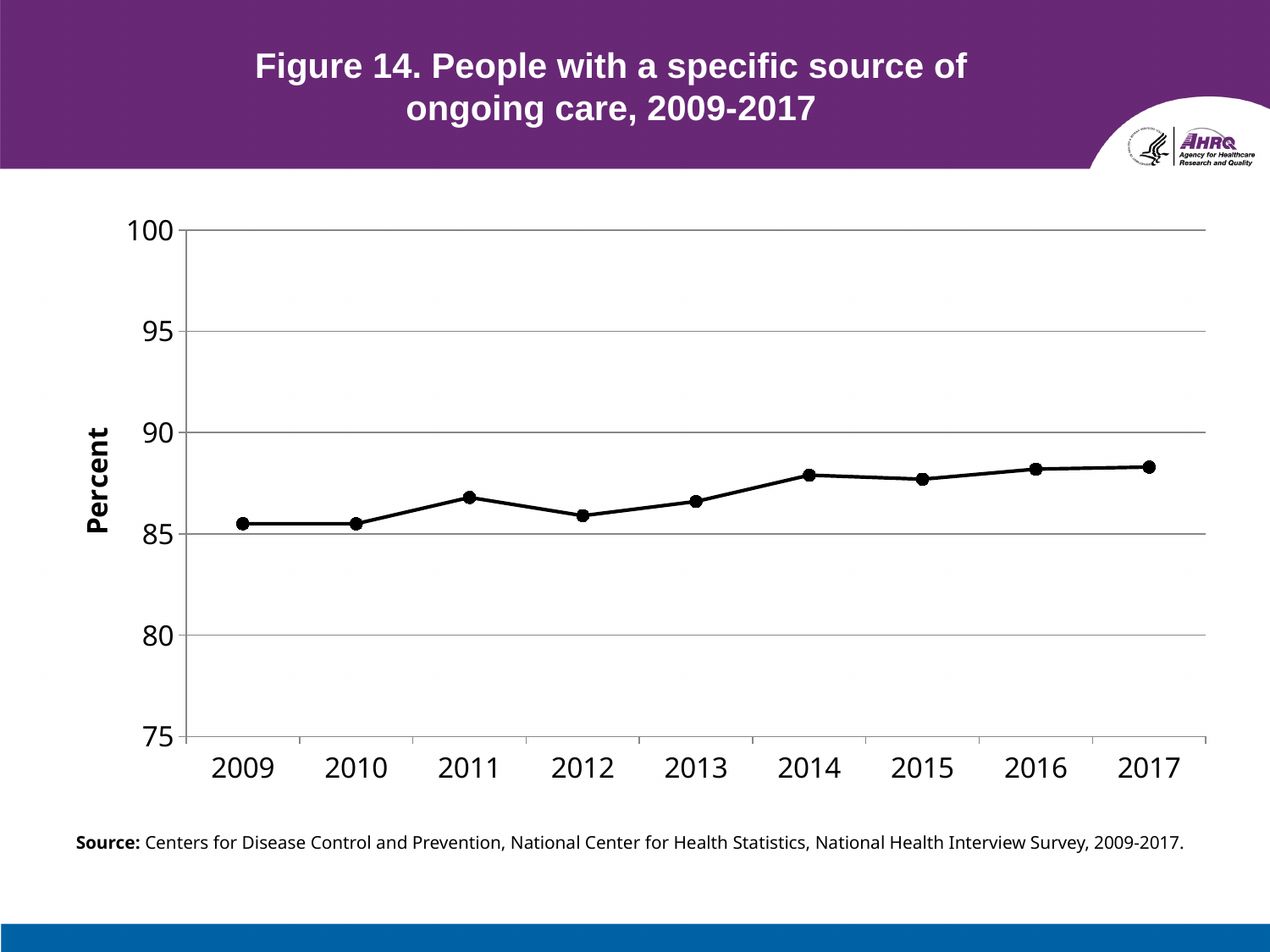
What kind of chart is shown on the slide? line chart What is the title of the chart? Figure 14. People with a specific source of ongoing care, 2009-2017 Which is larger, the value for 2009 or the value for 2017? 2017 What is the label on the y axis? Percent Is the value for 2011 greater or less than 90? less Is the value for 2017 greater or less than 90? less How many years are plotted on the x axis? 9 Is the value for 2016 greater or less than 85? greater Which is larger, the value for 2014 or the value for 2012? 2014 Which is larger, the value for 2011 or the value for 2010? 2011 Do the values generally rise or fall from 2009 to 2017? rise